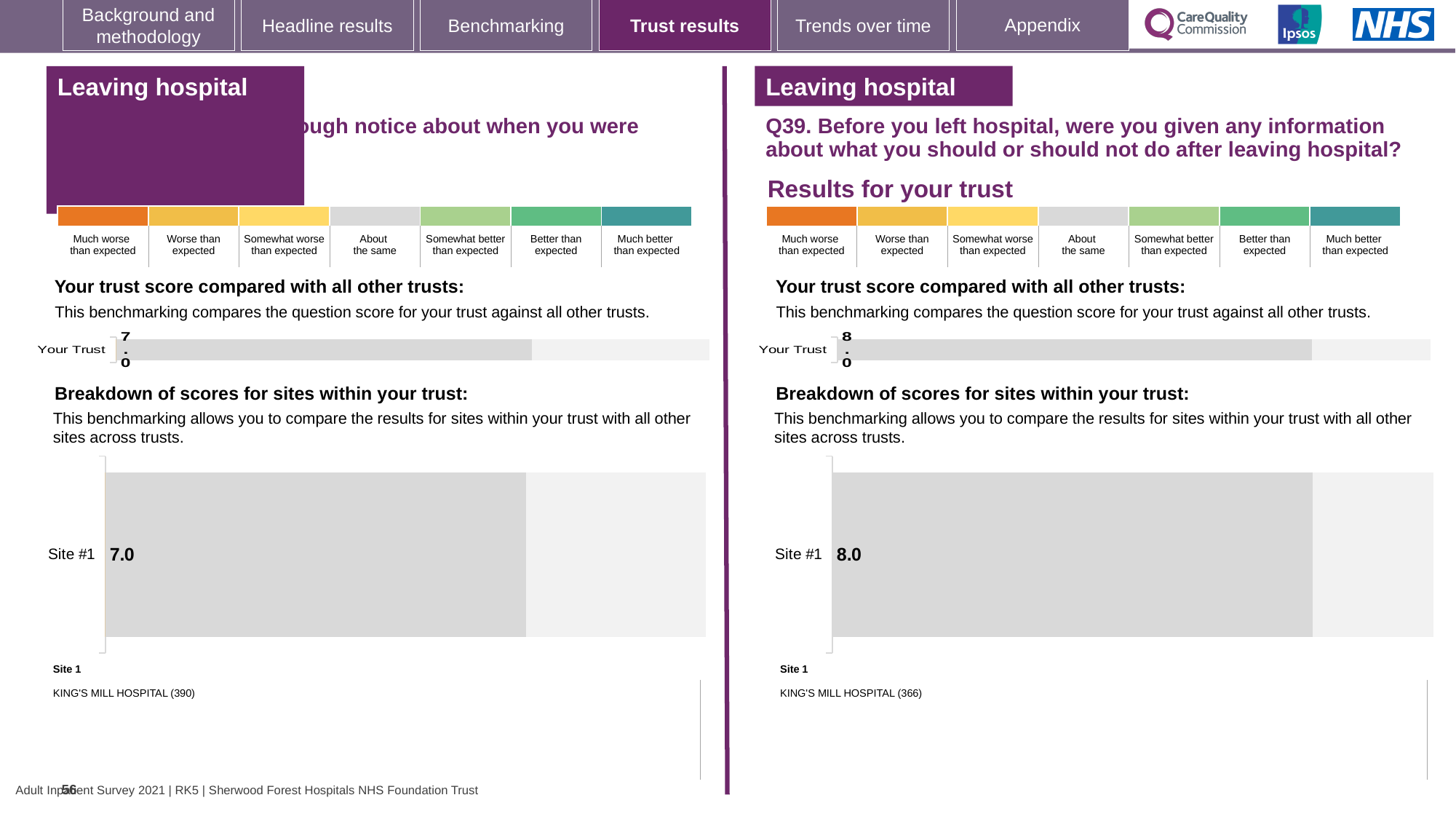
Which hospital is listed as Site 1 beneath the right-hand (Q39) breakdown chart? KING'S MILL HOSPITAL (366) On the left-hand side of the slide, what is the score shown for Your Trust in the 'Your trust score compared with all other trusts' chart? 7.0 On the right-hand side of the slide (Q39), what score is shown for Site #1 in the 'Breakdown of scores for sites within your trust' chart? 8.0 What is the difference between the Your Trust score on the right-hand side (Q39) and the Your Trust score on the left-hand side? 1.0 On the left-hand side of the slide, what score is shown for Site #1 in the 'Breakdown of scores for sites within your trust' chart? 7.0 What type of chart is used to show the Site #1 score on the right-hand side (Q39) of the slide? Bar chart Which hospital is listed as Site 1 beneath the left-hand breakdown chart? KING'S MILL HOSPITAL (390) What type of chart is used to show the Your Trust score on the left-hand side of the slide? Bar chart How many sites are plotted in the left-hand 'Breakdown of scores for sites within your trust' chart? 1 How many sites are plotted in the right-hand (Q39) 'Breakdown of scores for sites within your trust' chart? 1 Which is larger: the Site #1 score in the left-hand breakdown chart or the Site #1 score in the right-hand (Q39) breakdown chart? The right-hand (Q39) chart On the right-hand side of the slide (Q39), what is the score shown for Your Trust in the 'Your trust score compared with all other trusts' chart? 8.0